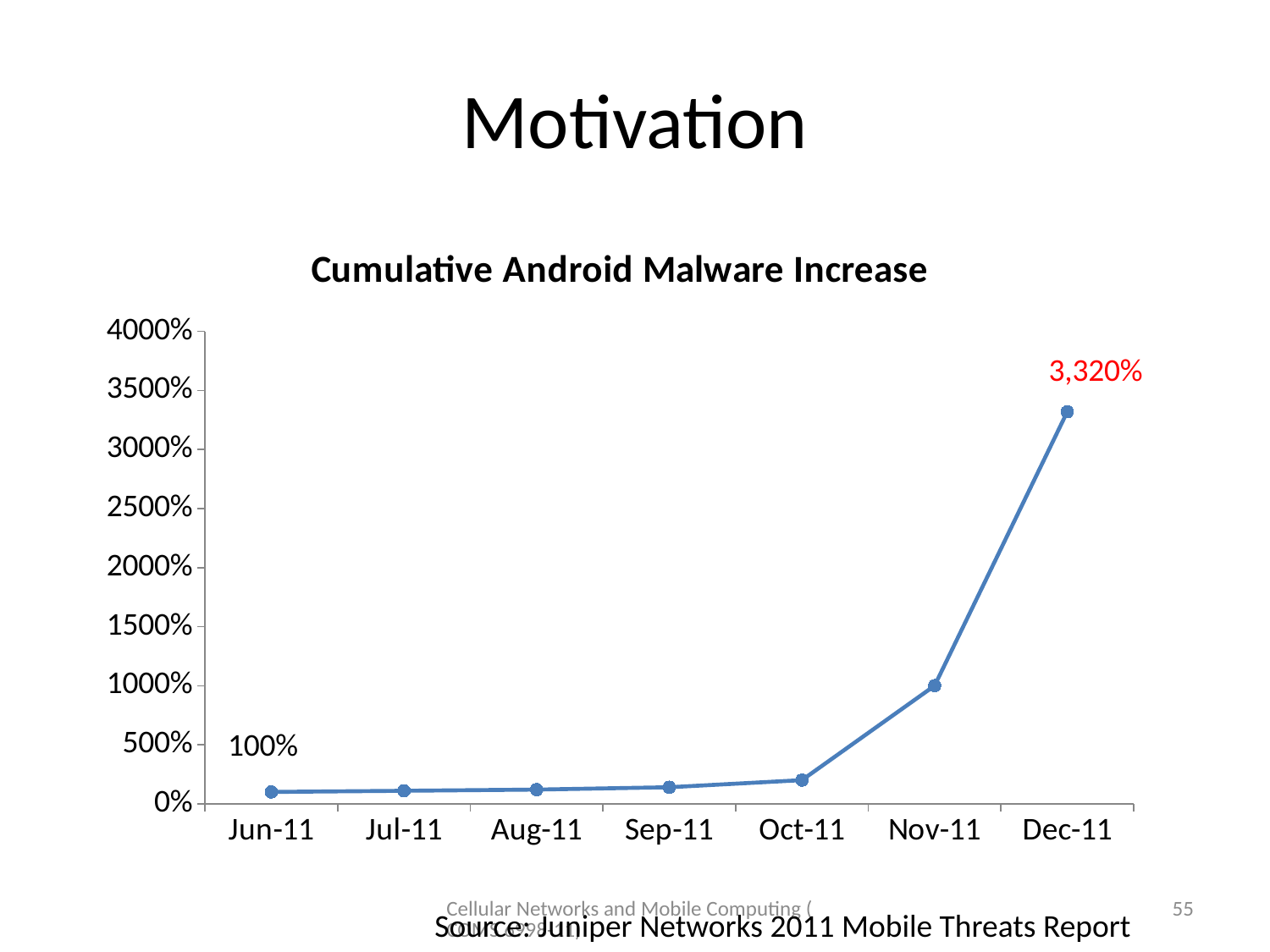
Do the values rise or fall from Jun-11 to Dec-11? rise Is the value for Nov-11 greater or less than 1500%? less Which is larger, the value for Oct-11 or the value for Nov-11? Nov-11 What is the difference between the values for Dec-11 and Jun-11? 3,220% How many data points are plotted on the chart? 7 Is the value for Oct-11 greater or less than 500%? less What is the value for Jun-11? 100% What is the title of the chart? Cumulative Android Malware Increase What kind of chart is shown on the slide? line chart Which month has the highest value? Dec-11 Is the value for Nov-11 greater or less than 500%? greater What is the value for Dec-11? 3,320%